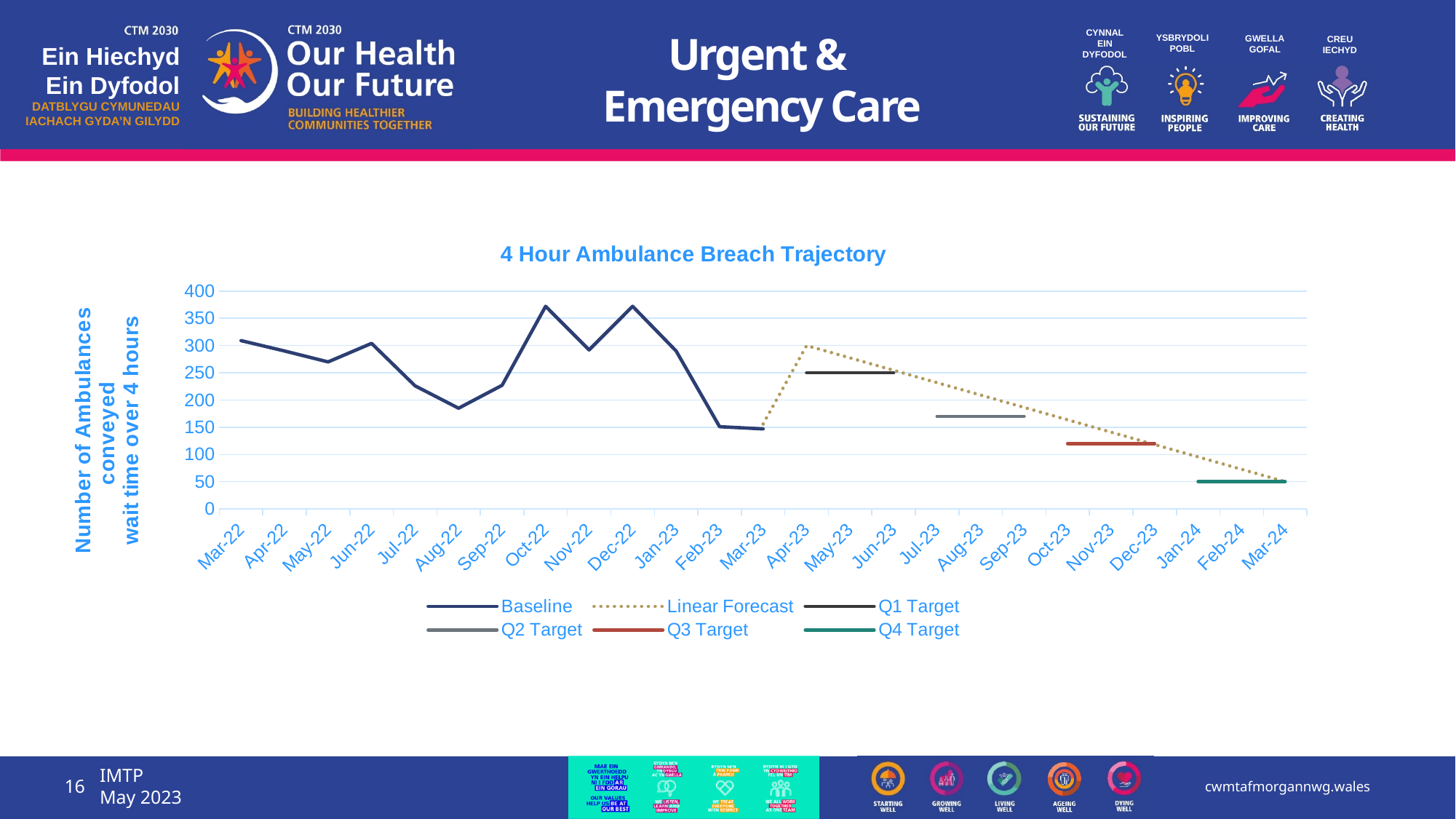
Is the Baseline value for Aug-22 greater or less than 200? less Which is larger, the Baseline value for Oct-22 or the Baseline value for Aug-22? Oct-22 Which of the target series (Q1, Q2, Q3, Q4) has the lowest value? Q4 Target What is the value of the Q4 Target line? 50 Is the Q3 Target value greater or less than 150? less Does the Linear Forecast line rise or fall from Apr-23 to Mar-24? Fall How many series does the chart legend list? 6 Is the Baseline value for Oct-22 greater or less than 350? greater What kind of chart is shown on the slide? Line chart What is the title of the chart? 4 Hour Ambulance Breach Trajectory Which of the target series (Q1, Q2, Q3, Q4) has the highest value? Q1 Target How many months are shown along the x axis of the chart? 25